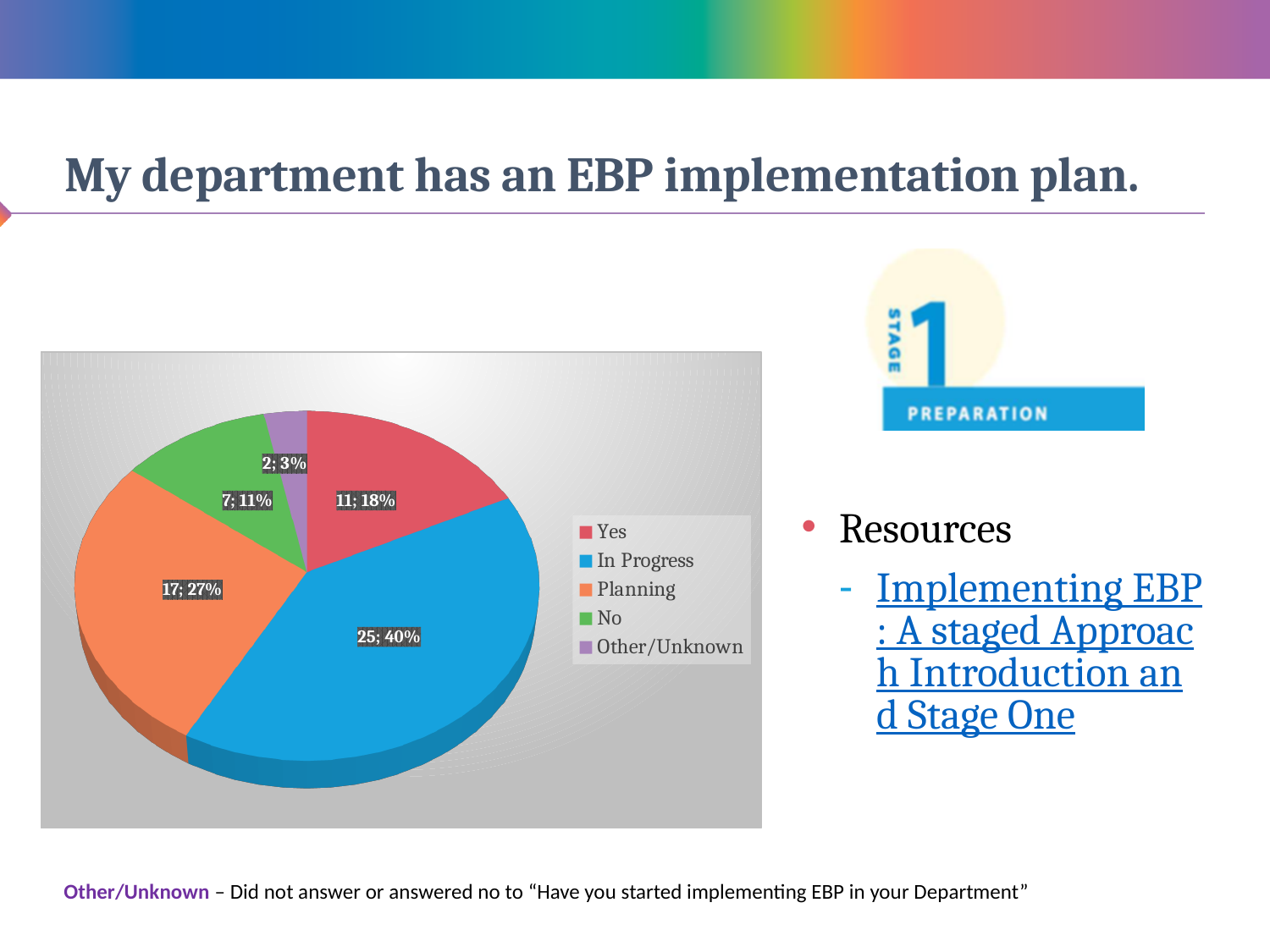
Which slice is larger, 'Yes' or 'No'? Yes What kind of chart is shown on the slide? Pie chart What colour is the 'Planning' slice in the pie chart? Orange Which category has the smallest slice in the pie chart? Other/Unknown What percentage of the pie does the 'Planning' slice represent? 27% What percentage of the pie does the 'Other/Unknown' slice represent? 3% Which category has the largest slice in the pie chart? In Progress How many entries does the pie chart's legend list? 5 What is the count for the 'Yes' slice of the pie chart? 11 What is the difference in count between the 'In Progress' and 'Planning' slices? 8 How many slices does the pie chart have? 5 What is the count for the 'In Progress' slice of the pie chart? 25